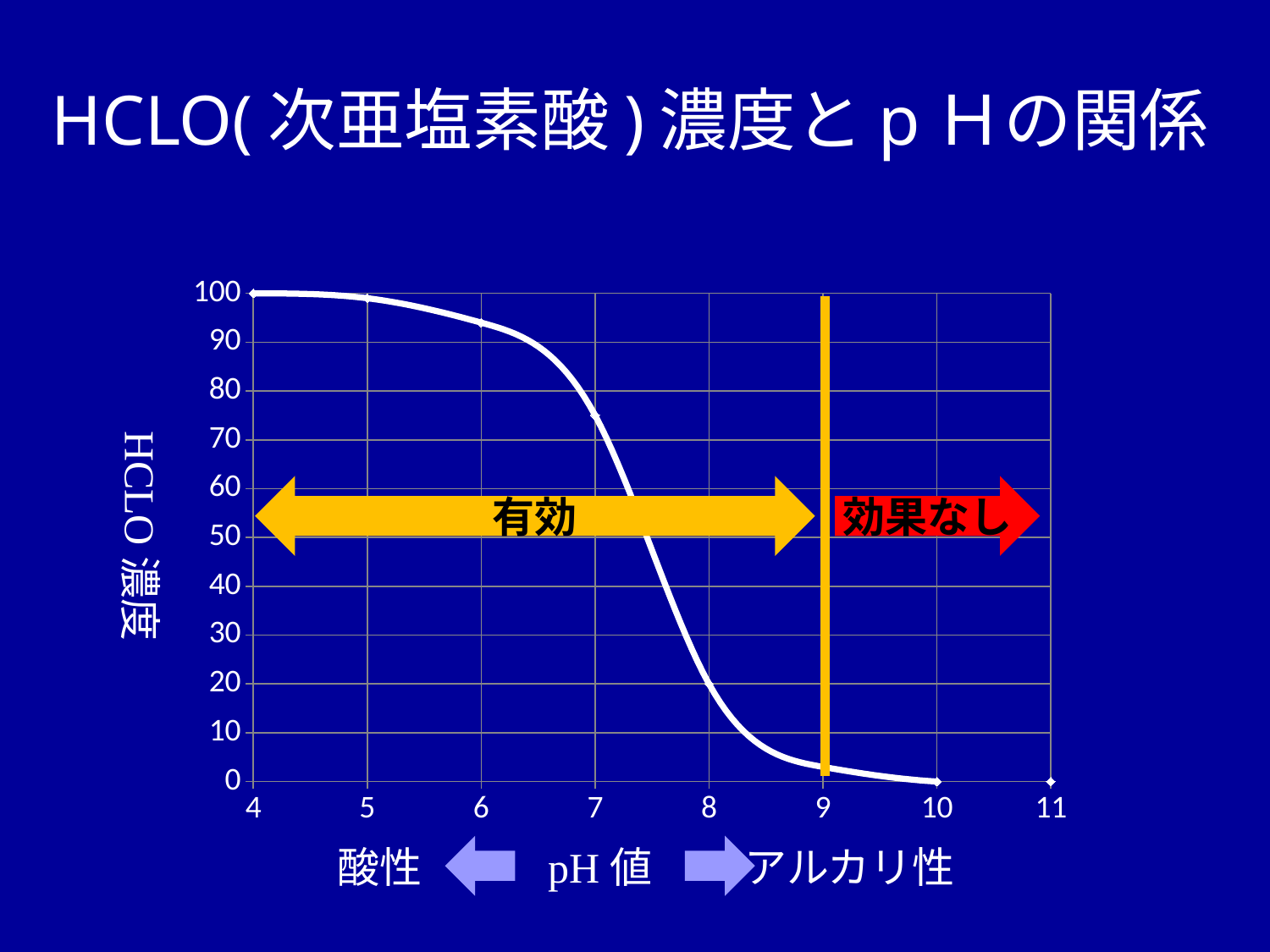
As pH increases along the x axis, does the HCLO concentration rise or fall? fall What is the HCLO concentration at pH 4? 100 At which pH value is the vertical orange line separating 有効 from 効果なし drawn? 9 Is the HCLO concentration at pH 6 greater or less than 80? greater Is the HCLO concentration at pH 9 greater or less than 10? less What is the label on the vertical axis of the chart? HCLO 濃度 Is the HCLO concentration at pH 7 greater or less than 60? greater How many pH values are labelled on the x axis? 8 Which has the higher HCLO concentration, pH 6 or pH 8? pH 6 What kind of chart is shown on the slide? line chart